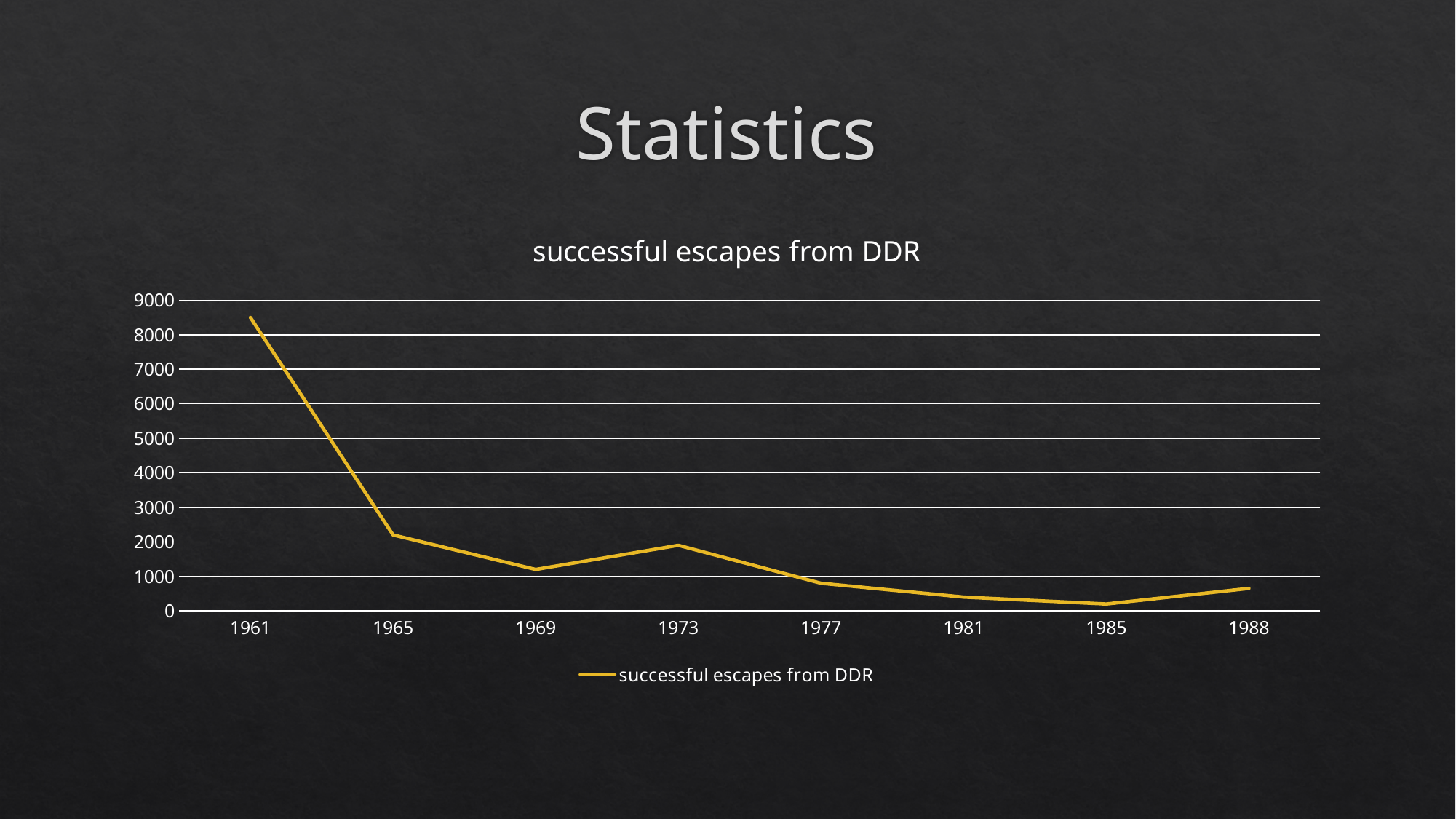
What is the title of the chart? successful escapes from DDR How many years are plotted on the x axis? 8 Is the value for 1977 greater or less than 1000? less Which year has the larger value, 1969 or 1973? 1973 Overall, do the values rise or fall from 1961 to 1988? fall Is the value for 1973 greater or less than 2000? less Which year has the lowest number of successful escapes from DDR? 1985 Is the value for 1961 greater or less than 8000? greater What kind of chart is shown on the slide? line chart Which year has the highest number of successful escapes from DDR? 1961 How many series does the legend list? 1